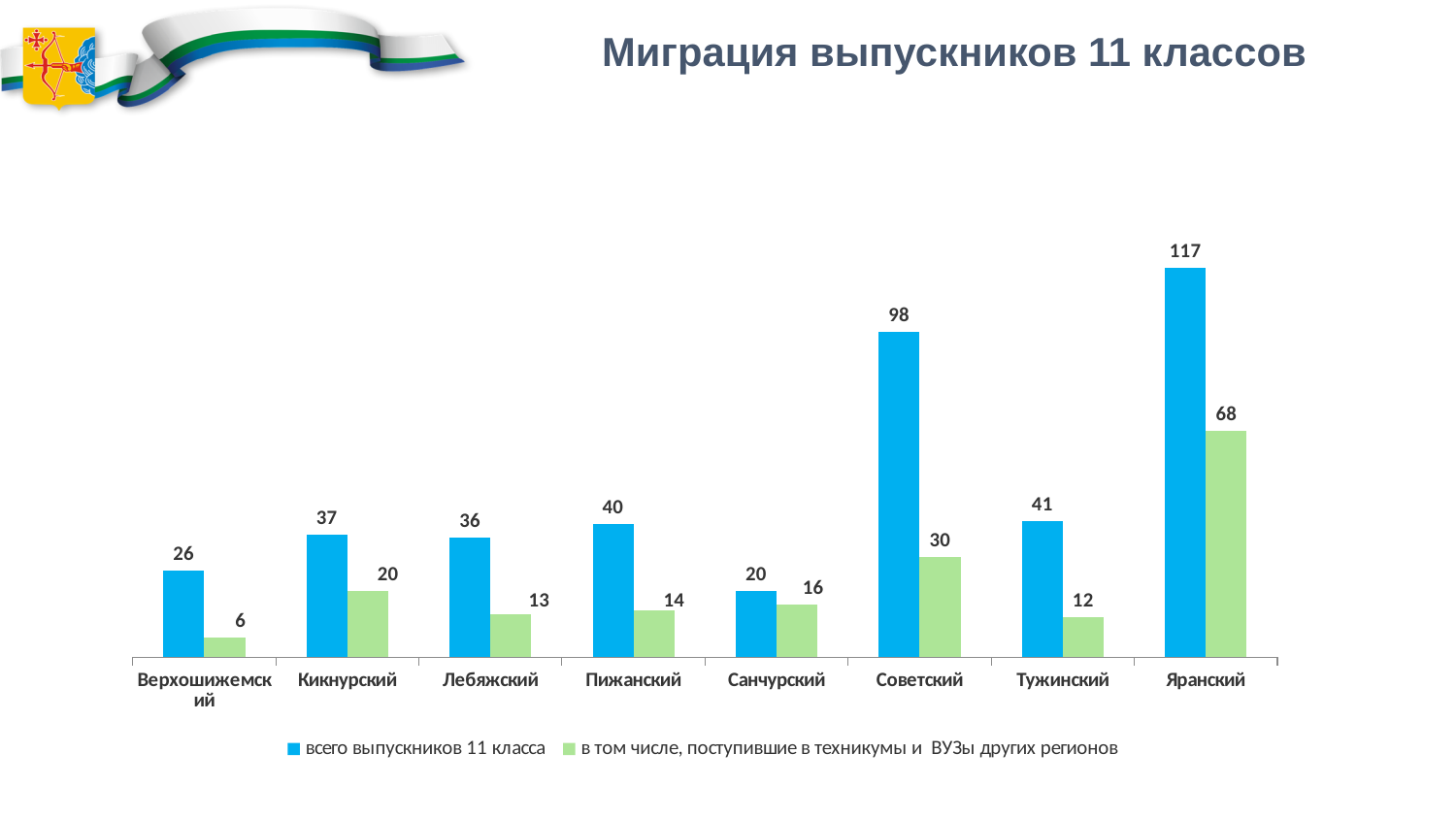
What kind of chart is shown on the slide? Bar chart What is the title of the chart? Миграция выпускников 11 классов Which is larger: 'всего выпускников 11 класса' for Тужинский or for Пижанский? Тужинский Which district has the lowest value for 'в том числе, поступившие в техникумы и ВУЗы других регионов'? Верхошижемский What is the difference between 'всего выпускников 11 класса' and 'в том числе, поступившие в техникумы и ВУЗы других регионов' for Яранский? 49 What is the difference in 'всего выпускников 11 класса' between Советский and Тужинский? 57 How many districts are shown on the x axis? 8 How many series does the legend list? 2 What is the value of 'всего выпускников 11 класса' for Советский? 98 Which district has the highest value for 'всего выпускников 11 класса'? Яранский What is the value of 'в том числе, поступившие в техникумы и ВУЗы других регионов' for Кикнурский? 20 What is the value of 'всего выпускников 11 класса' for Санчурский? 20